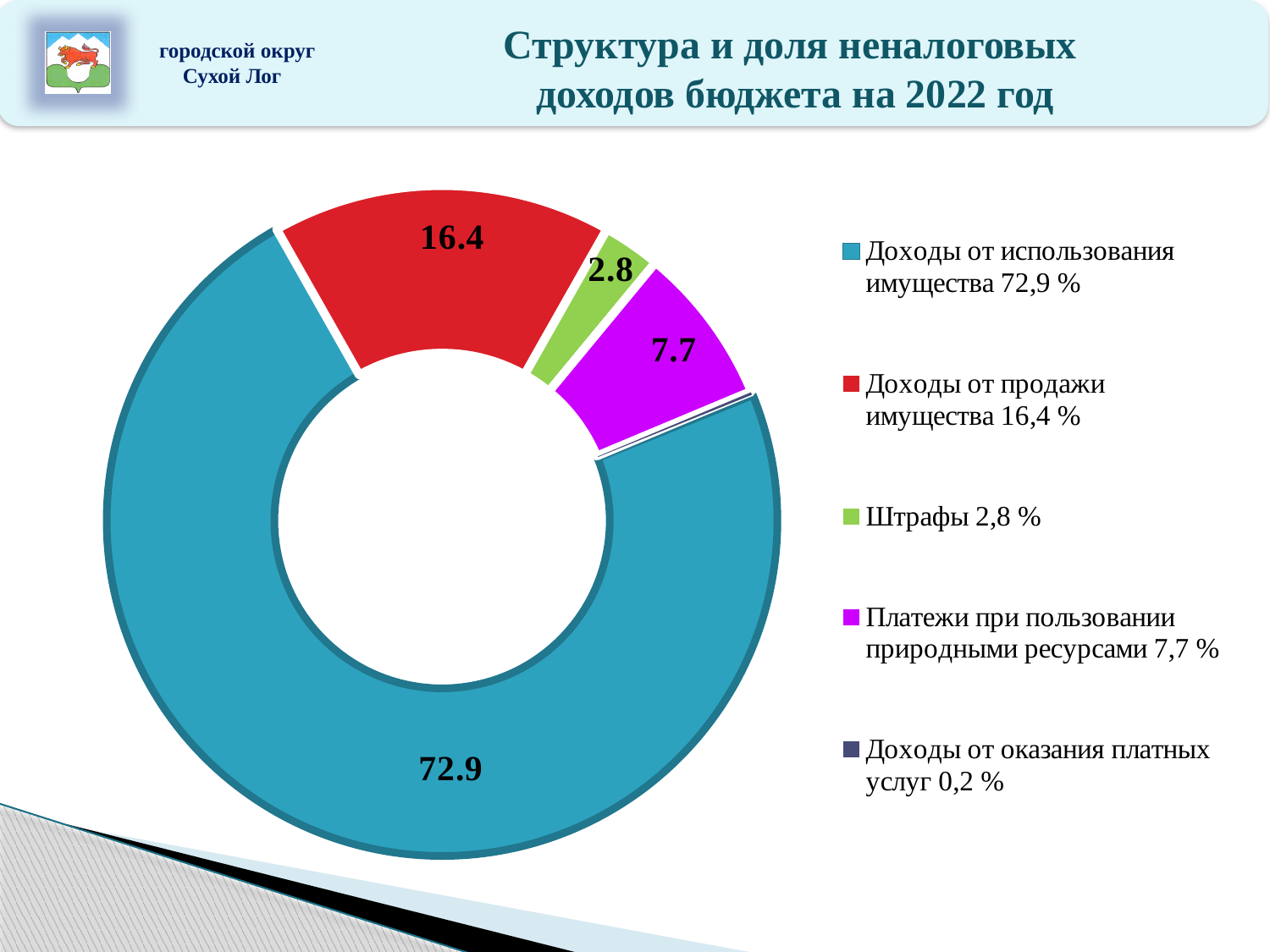
Which category has the largest slice of the chart? Доходы от использования имущества According to the legend, what share do Доходы от оказания платных услуг have? 0,2 % How many categories does the legend list? 5 What is the data label on the slice for Платежи при пользовании природными ресурсами? 7.7 What type of chart is shown on the slide? Doughnut (pie) chart What is the data label on the slice for Доходы от продажи имущества? 16.4 What is the data label on the slice for Штрафы? 2.8 Which is larger: the slice for Платежи при пользовании природными ресурсами or the slice for Штрафы? Платежи при пользовании природными ресурсами What is the difference between the data labels for Доходы от использования имущества and Доходы от продажи имущества? 56.5 Which category has the smallest share according to the legend? Доходы от оказания платных услуг What is the title of the slide containing the chart? Структура и доля неналоговых доходов бюджета на 2022 год What is the data label on the slice for Доходы от использования имущества? 72.9